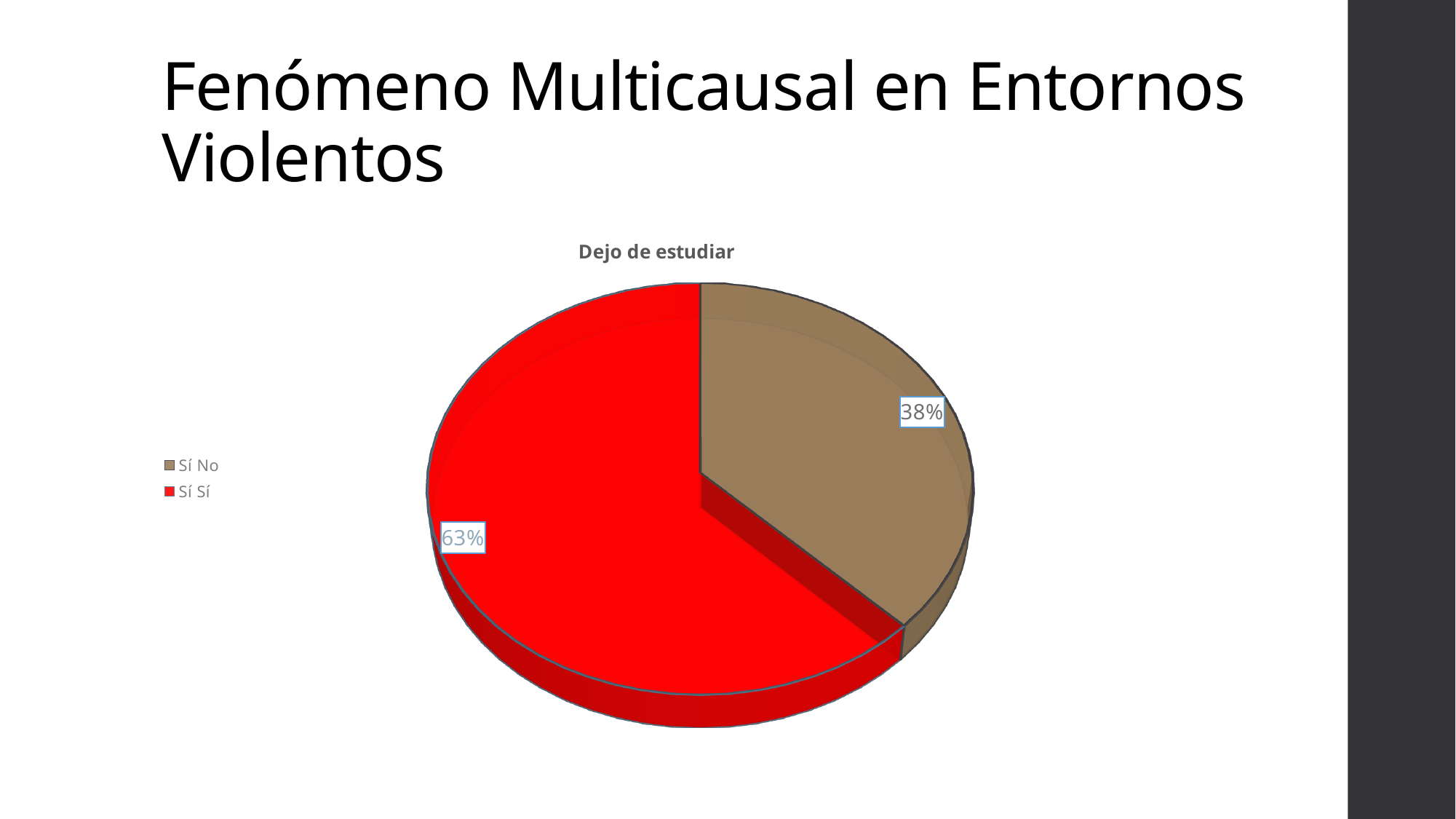
What kind of chart is shown on the slide? pie chart What percentage is shown for the "Sí Sí" slice? 63% What percentage is shown for the "Sí No" slice? 38% How many entries does the legend list? 2 Which is larger, the "Sí Sí" slice or the "Sí No" slice? Sí Sí Which slice is the largest? Sí Sí What is the difference in percentage points between the "Sí Sí" and "Sí No" slices? 25 How many slices does the pie chart have? 2 Is the value for "Sí No" greater or less than 50%? less What is the title of the chart? Dejo de estudiar What colour is the "Sí Sí" slice? red Which slice is the smallest? Sí No